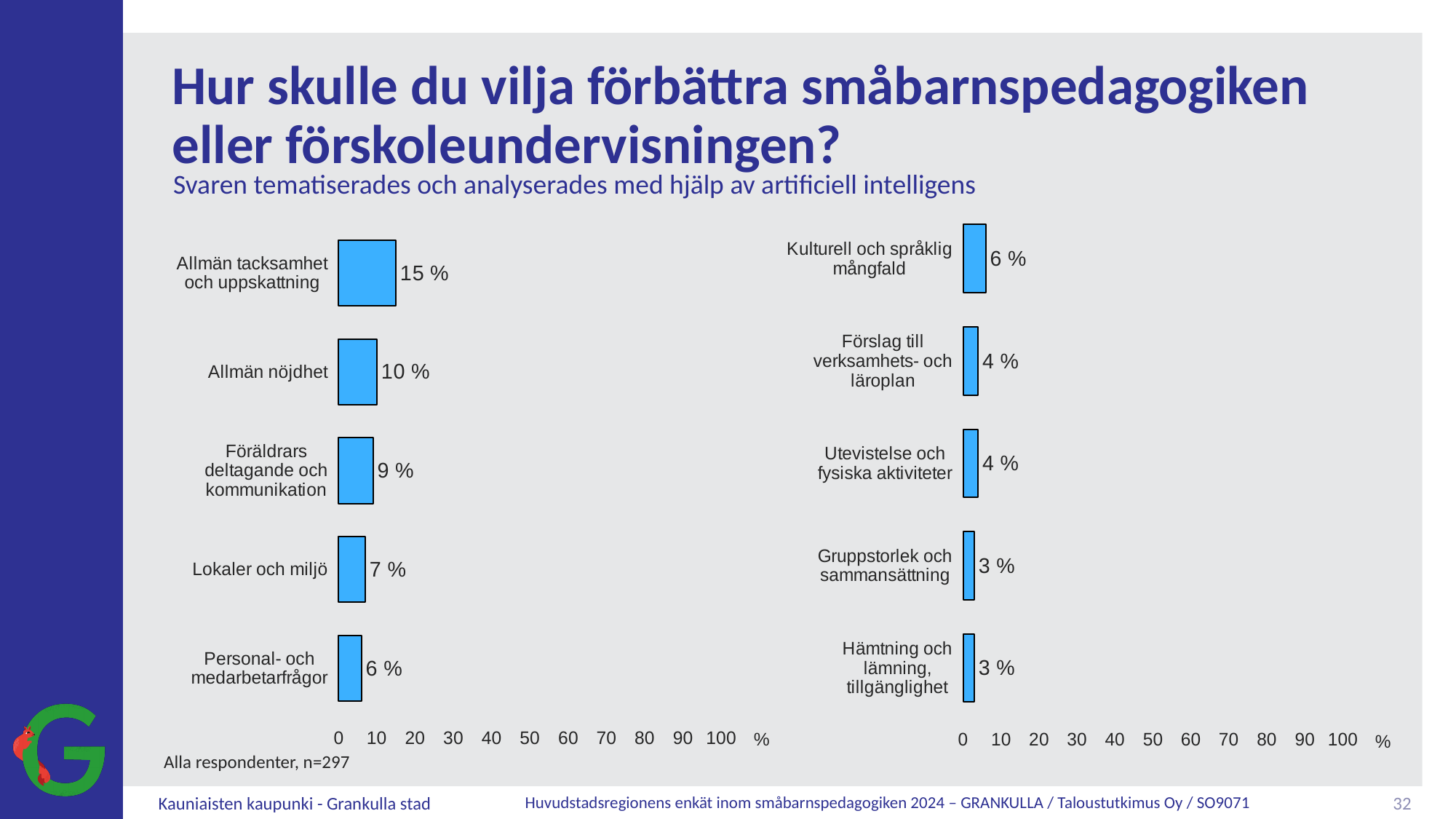
In the left chart, what is the value for Lokaler och miljö? 7 % In the left chart, which is larger: Föräldrars deltagande och kommunikation or Lokaler och miljö? Föräldrars deltagande och kommunikation In the right chart, what is the value for Kulturell och språklig mångfald? 6 % In the left chart, what is the difference between Allmän tacksamhet och uppskattning and Allmän nöjdhet? 5 % How many categories are shown in the right chart? 5 In the right chart, what is the value for Gruppstorlek och sammansättning? 3 % In the right chart, what is the difference between Kulturell och språklig mångfald and Hämtning och lämning, tillgänglighet? 3 % In the right chart, which category has the highest value? Kulturell och språklig mångfald In the left chart, what is the value for Allmän tacksamhet och uppskattning? 15 % In the left chart, which category has the lowest value? Personal- och medarbetarfrågor What kind of chart is shown on the left of the slide? Bar chart In the left chart, which category has the highest value? Allmän tacksamhet och uppskattning